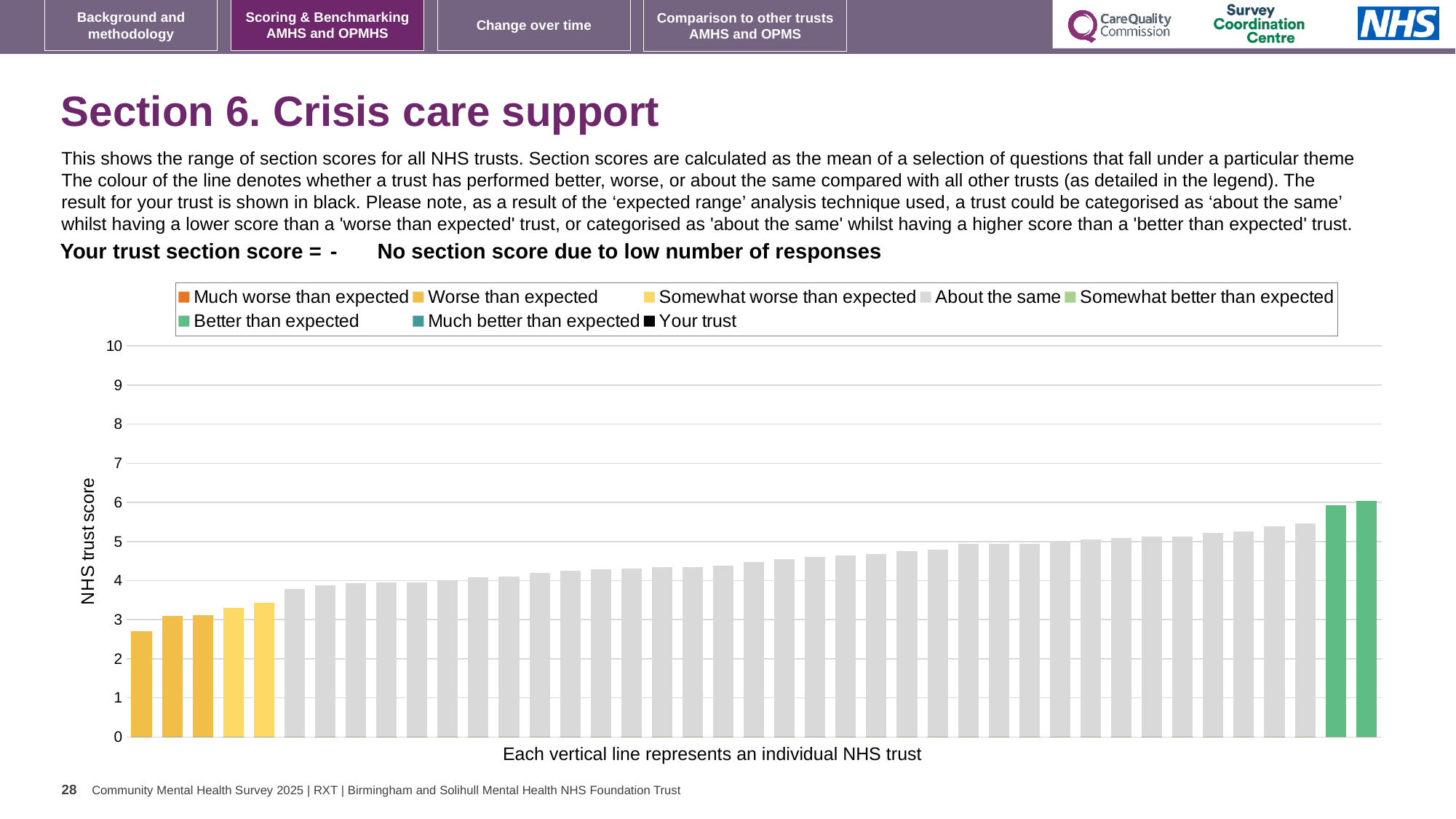
How many green 'Better than expected' bars are shown in the chart? 2 What kind of chart is shown on the slide? Bar chart Do the bar values rise or fall moving from left to right along the x axis? Rise What is the label on the vertical axis of the chart? NHS trust score Is the value of the rightmost bar greater or less than 5? greater What is the highest value shown on the vertical axis of the chart? 10 Which legend category does the highest bar in the chart belong to? Better than expected How many bars are coloured in the 'Worse than expected' category? 3 Is the value of the tallest bar greater or less than 7? less Which legend category does the lowest bar in the chart belong to? Worse than expected How many entries does the chart legend list? 8 Is the value of the leftmost bar greater or less than 3? less